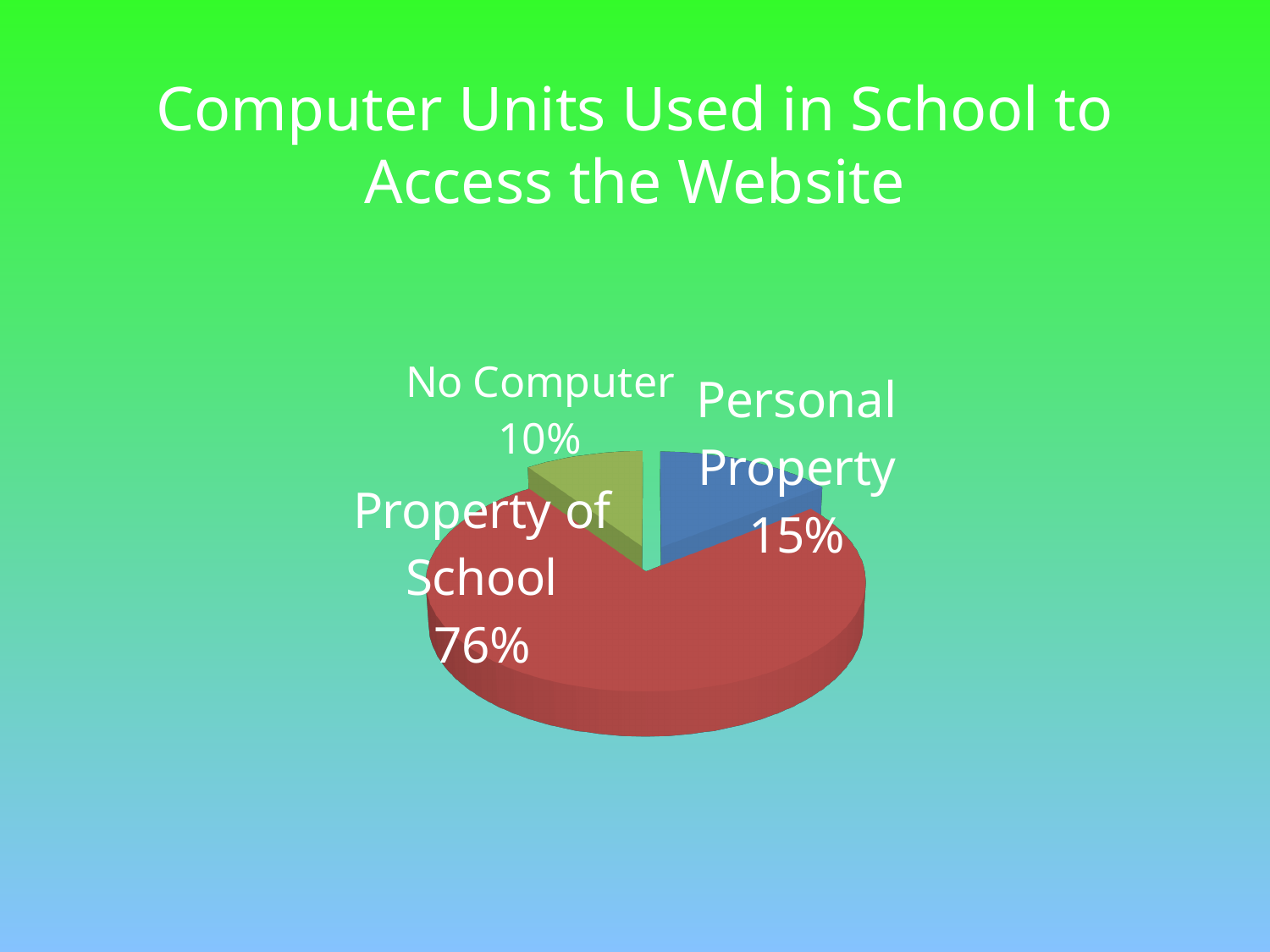
What kind of chart is shown on the slide? pie chart What is the difference in percentage points between Personal Property and No Computer? 5 Which category has the largest share of the pie? Property of School What percentage of the pie is labelled Property of School? 76% What percentage of the pie is labelled Personal Property? 15% What colour is the Property of School slice? red What percentage of the pie is labelled No Computer? 10% How many slices does the pie chart have? 3 What is the title of the chart on the slide? Computer Units Used in School to Access the Website Which is larger, the share for Personal Property or the share for No Computer? Personal Property What is the difference in percentage points between Property of School and Personal Property? 61 Which category has the smallest share of the pie? No Computer